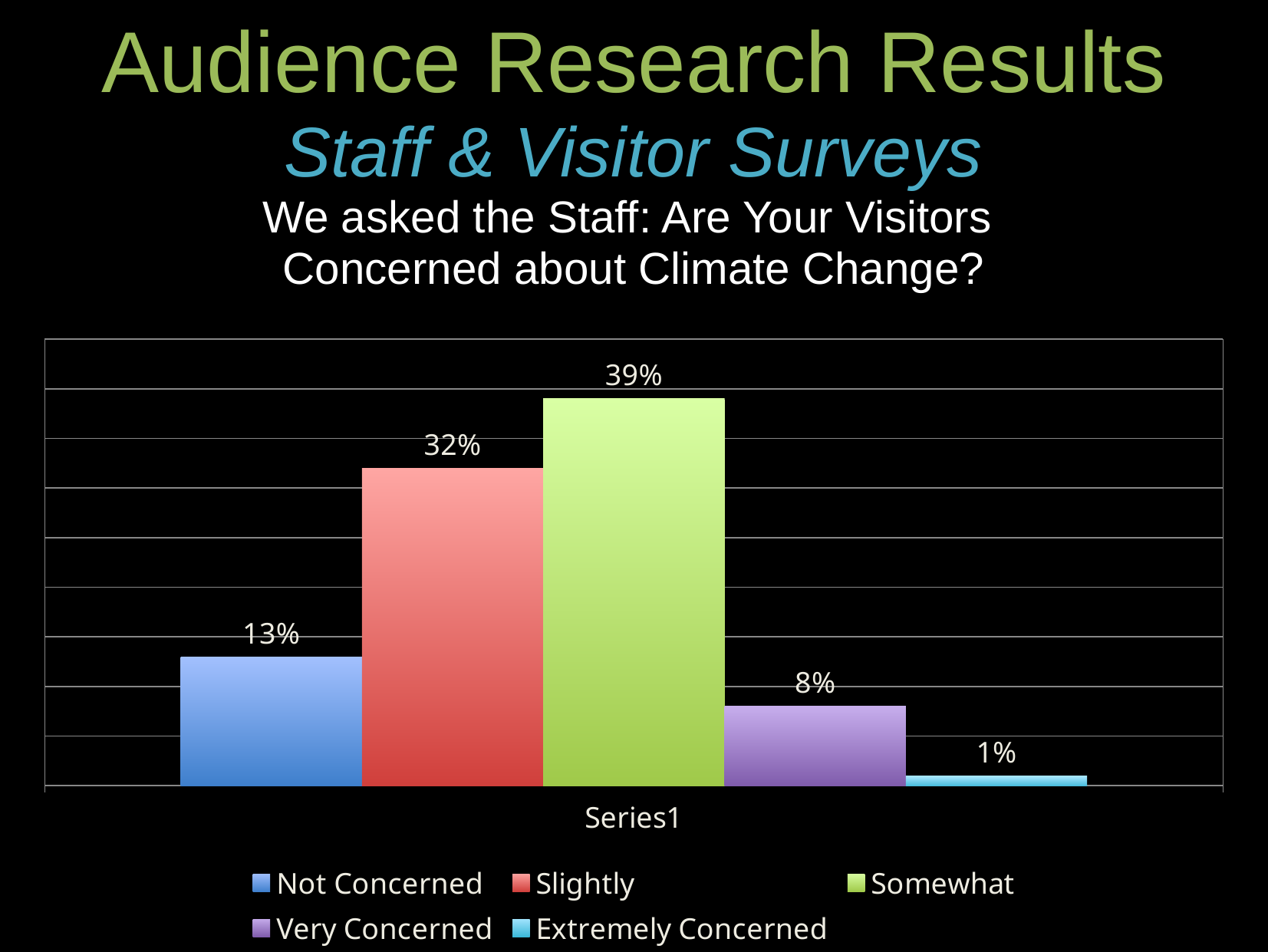
What value is shown for the Somewhat concerned bar? 39% What kind of chart is shown on the slide? Bar chart Which is larger, the value for Not Concerned or the value for Very Concerned? Not Concerned What value is shown for the Slightly concerned bar? 32% What colour is the bar for Somewhat? Green What percentage of staff said their visitors are Not Concerned about climate change? 13% How many response categories does the legend list? 5 Which response category has the highest value? Somewhat What percentage is shown for Extremely Concerned? 1% What percentage is shown for Very Concerned? 8% Which response category has the lowest value? Extremely Concerned What is the difference between the Somewhat and Slightly values? 7%